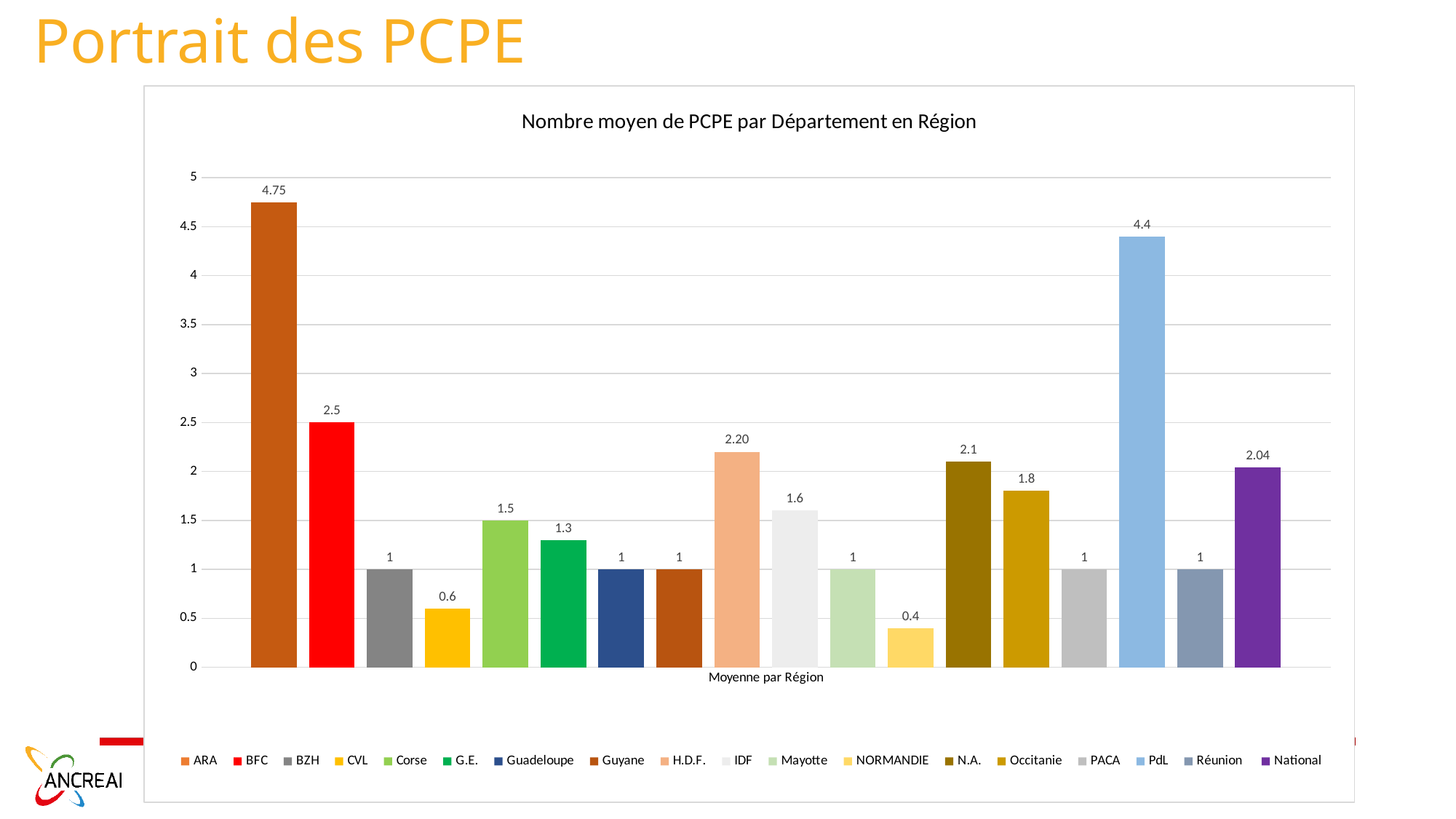
Which is larger, the value for BFC or the value for N.A.? BFC Is the value for Occitanie greater or less than 2? less What is the value for ARA? 4.75 What kind of chart is shown? Bar chart Which region has the highest value? ARA How many series does the legend list? 18 What is the title of the chart? Nombre moyen de PCPE par Département en Région What is the difference between the values for ARA and PdL? 0.35 What is the value for PdL? 4.4 What is the value for H.D.F.? 2.20 Which region has the lowest value? NORMANDIE What is the value for National? 2.04